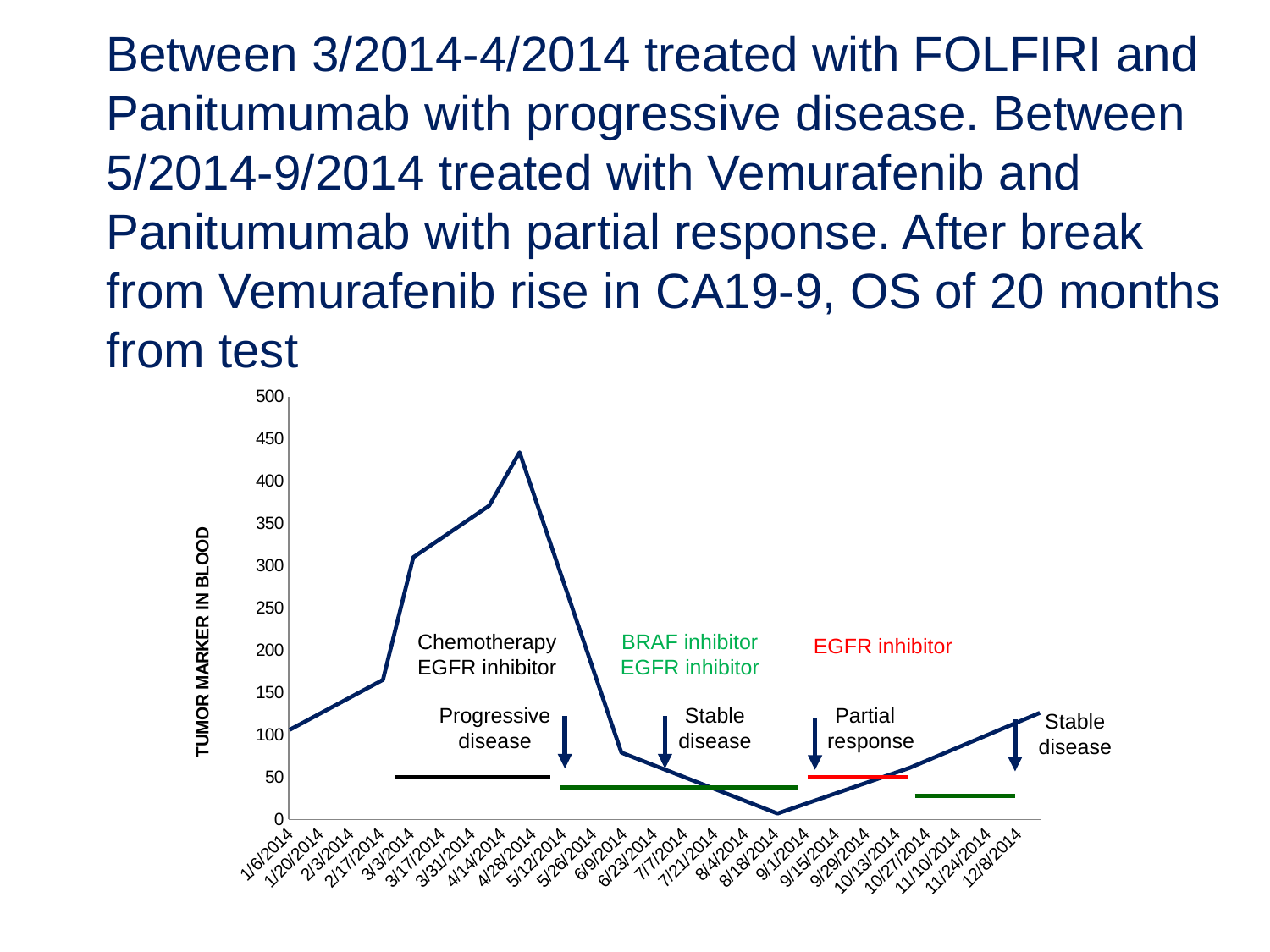
Is the tumor marker value at 3/3/2014 greater or less than 250? greater Which date has the higher tumor marker value, 4/28/2014 or 6/9/2014? 4/28/2014 Is the tumor marker value at 12/8/2014 greater or less than 200? less How many date labels are shown on the x axis of the chart? 25 What is the title of the vertical axis of the chart? TUMOR MARKER IN BLOOD Does the tumor marker value rise or fall between 4/28/2014 and 8/18/2014? fall Is the tumor marker value at 1/6/2014 greater or less than 150? less What kind of chart is shown on the slide? line chart